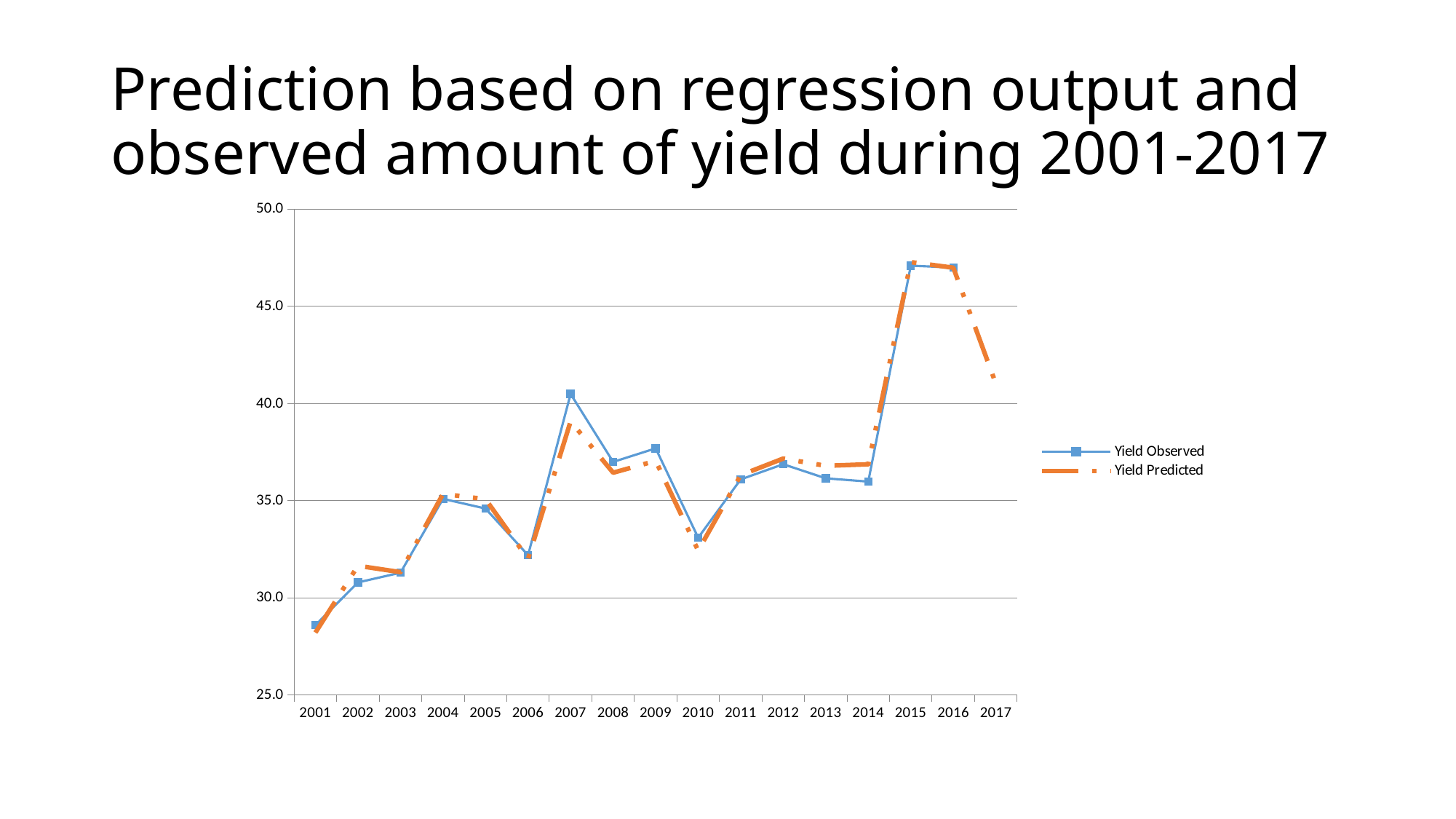
How many series does the legend list? 2 Is the Yield Predicted value for 2017 greater or less than 40.0? greater Which is larger, the Yield Observed value for 2007 or for 2008? 2007 Which year has the lowest Yield Observed value? 2001 What kind of chart is shown on the slide? line chart Does the Yield Observed line rise or fall from 2001 to 2004? rise Is the Yield Observed value for 2010 greater or less than 35.0? less Does the Yield Predicted line rise or fall from 2016 to 2017? fall Is the Yield Observed value for 2015 greater or less than 45.0? greater Which series is drawn with a dashed orange line? Yield Predicted How many years are shown on the x axis? 17